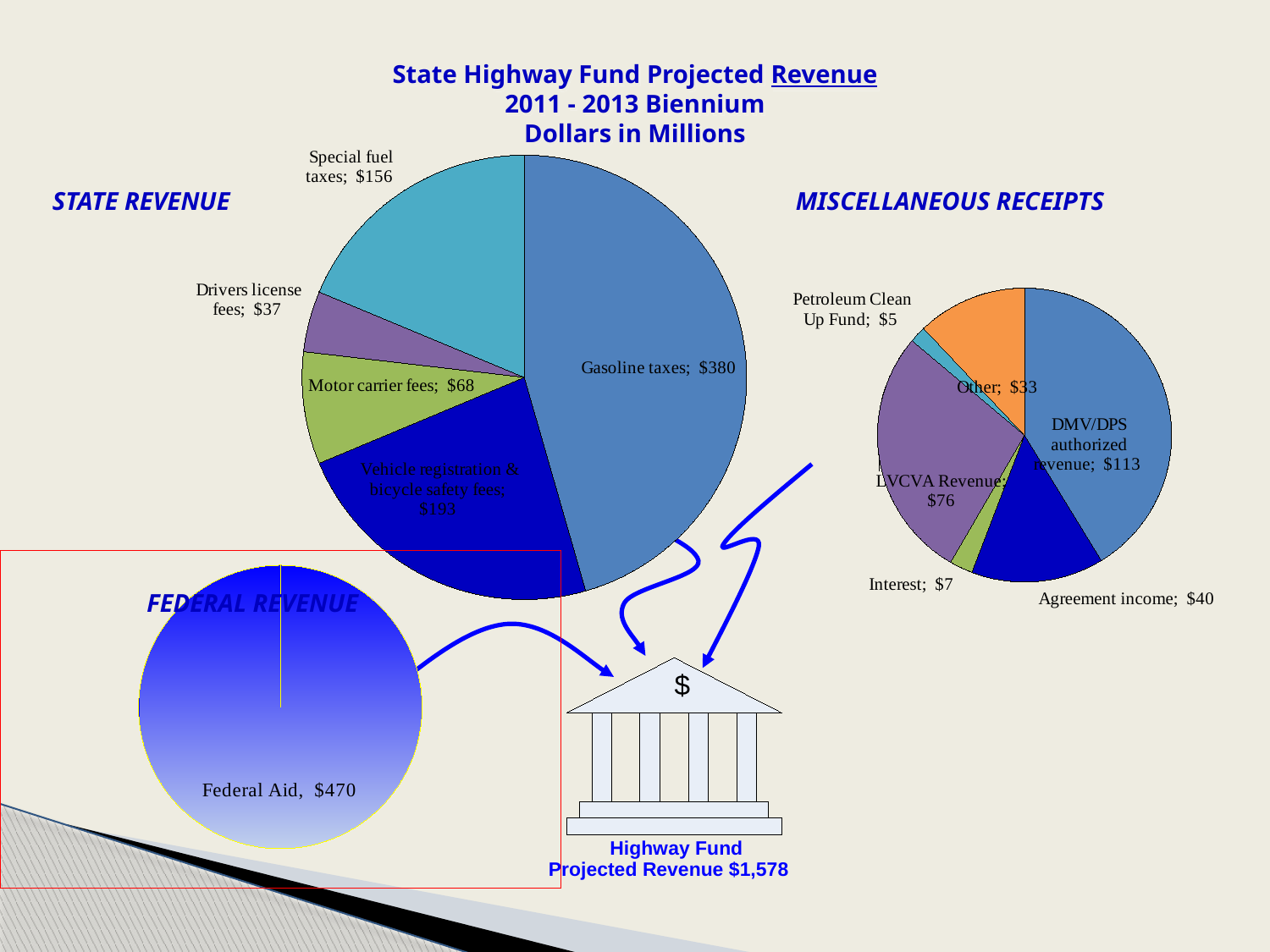
In the Miscellaneous Receipts pie chart, which category has the largest value? DMV/DPS authorized revenue In the Miscellaneous Receipts pie chart, what is the value for LVCVA Revenue? $76 In the State Revenue pie chart, what is the value for Gasoline taxes? $380 What type of chart is used for State Revenue and Miscellaneous Receipts? Pie chart How many categories does the State Revenue pie chart show? 5 In the Miscellaneous Receipts pie chart, which is larger, Agreement income or Other? Agreement income How many categories does the Miscellaneous Receipts pie chart show? 6 In the State Revenue pie chart, which category has the largest value? Gasoline taxes In the State Revenue pie chart, what is the value for Motor carrier fees? $68 In the State Revenue pie chart, which category has the smallest value? Drivers license fees In the Miscellaneous Receipts pie chart, which category has the smallest value? Petroleum Clean Up Fund In the State Revenue pie chart, what is the difference between Gasoline taxes and Vehicle registration & bicycle safety fees? $187